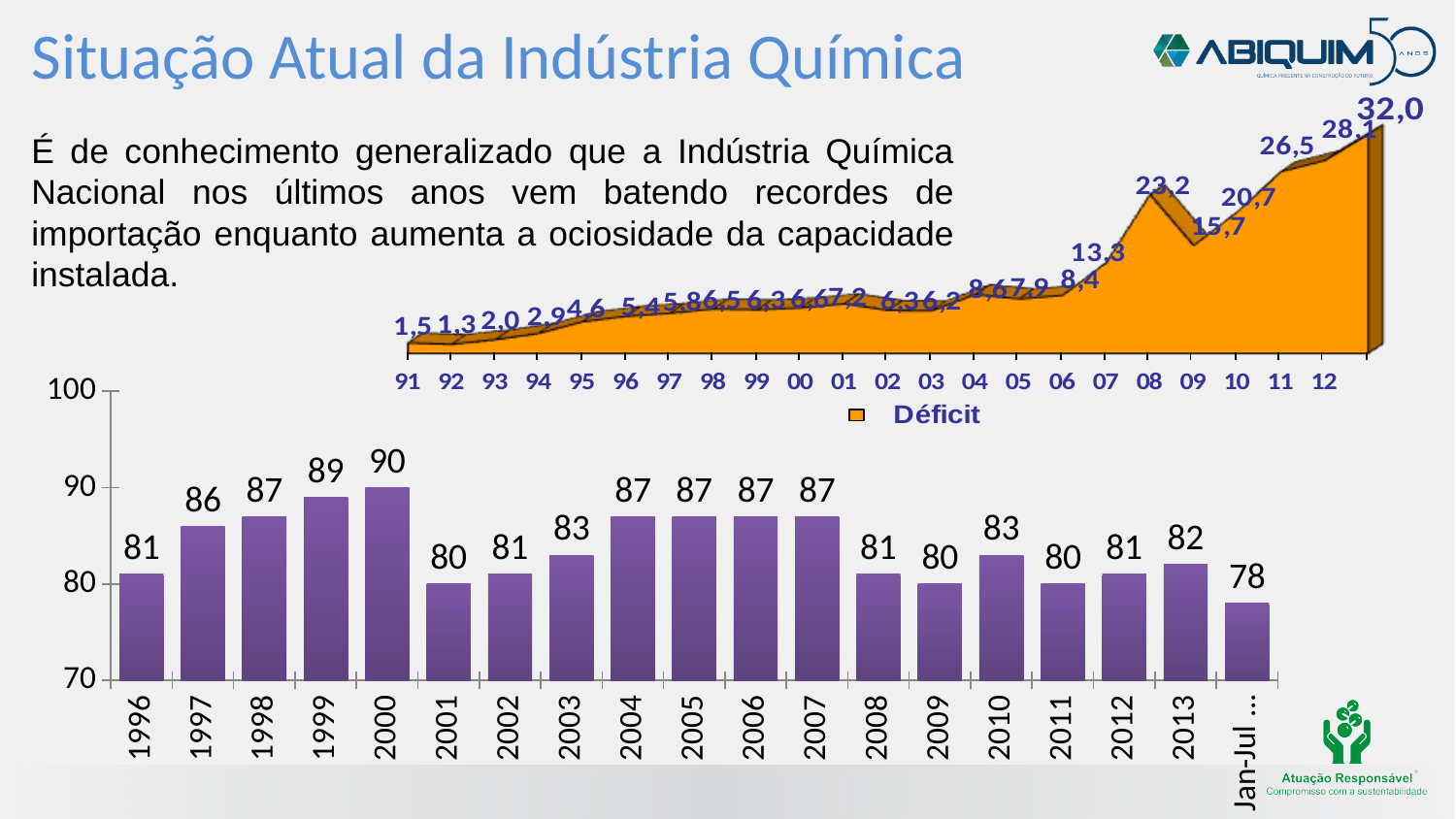
In the bottom bar chart, what is the value for 2013? 82 What series name does the legend of the top-right chart show? Déficit In the bottom bar chart, which is larger, the value for 1997 or the value for 2008? 1997 In the bottom bar chart, which year has the highest value? 2000 In the top-right Déficit chart, what is the value for 11? 26,5 In the bottom bar chart, what is the value for 2000? 90 In the bottom bar chart, what is the difference between the values for 1999 and 2001? 9 In the bottom bar chart, which category has the lowest value? Jan-Jul ... How many bars are in the bottom bar chart? 19 In the top-right Déficit chart, what is the value for 08? 23,2 In the top-right Déficit chart, what is the difference between the values for 12 and 09? 12,4 What kind of chart is the bottom chart on the slide? Bar chart